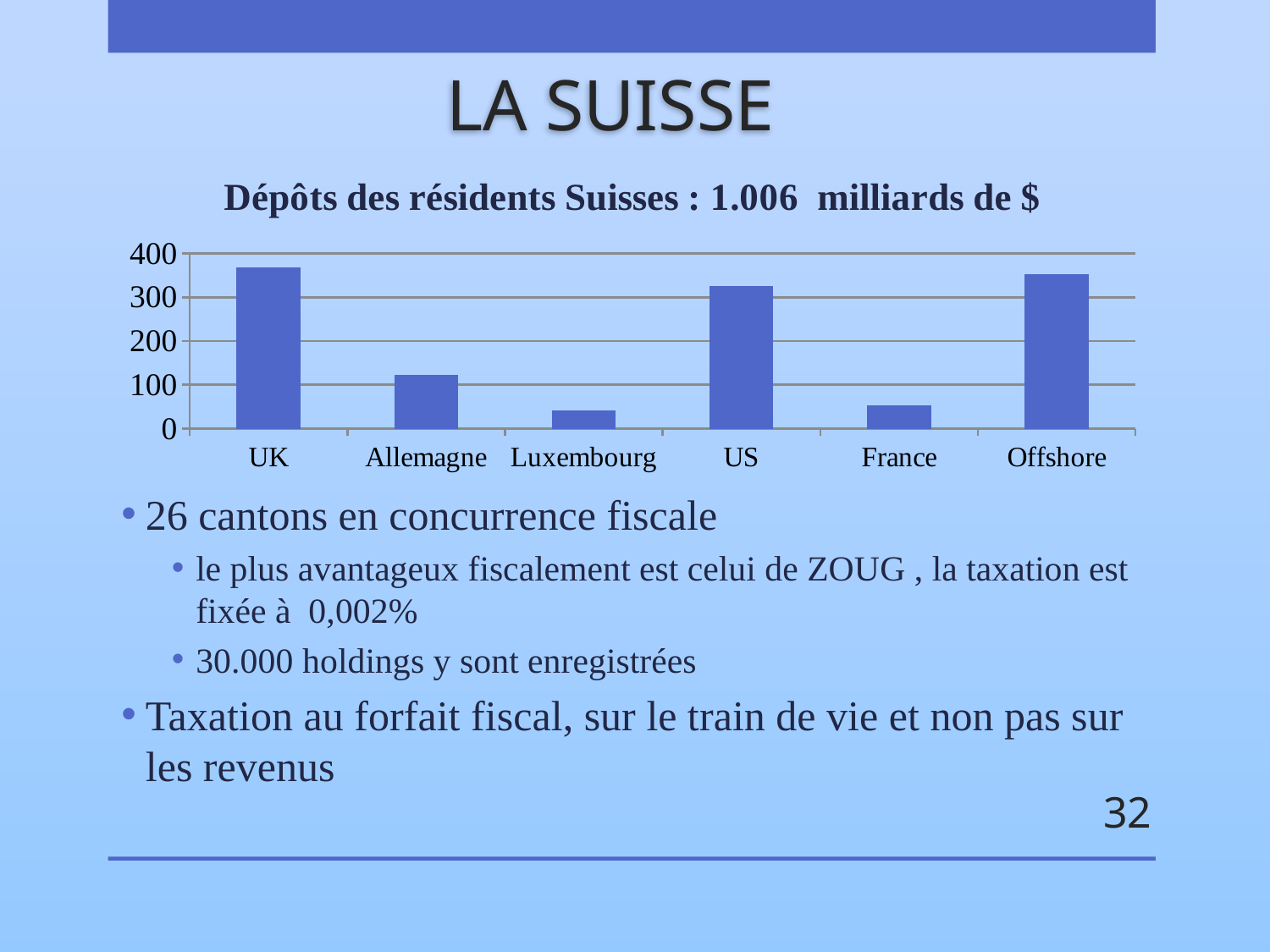
Is the value for Allemagne greater or less than 200? less Is the value for US greater or less than 300? greater Is the value for Offshore greater or less than 300? greater How many categories are shown on the x axis of the chart? 6 Which has the larger value, France or US? US Which has the larger value, Allemagne or Luxembourg? Allemagne What kind of chart is shown on the slide? bar chart Which has the larger value, UK or Allemagne? UK What is the title of the chart? Dépôts des résidents Suisses : 1.006 milliards de $